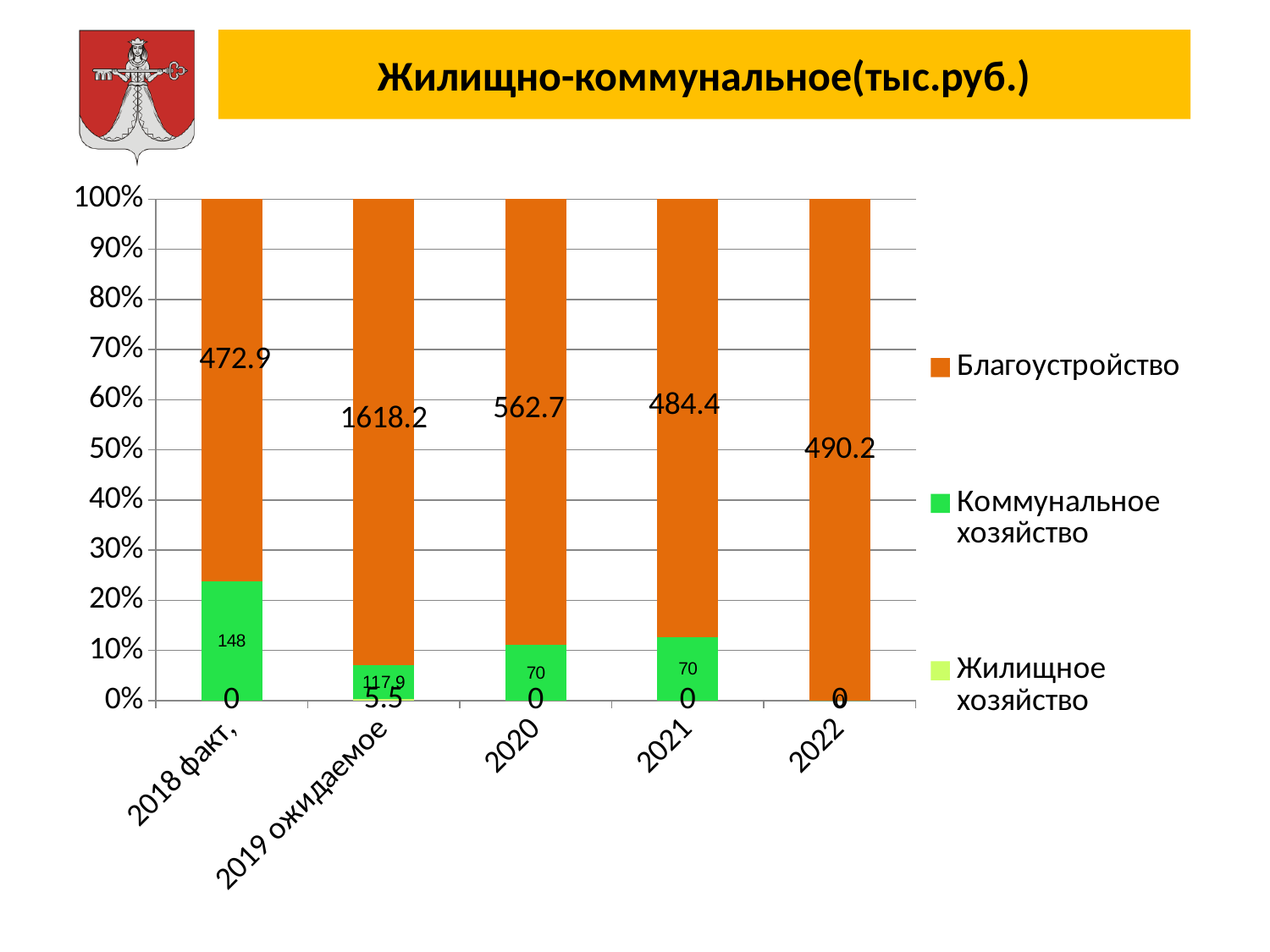
Which category has the highest value for Благоустройство? 2019 ожидаемое What is the value of Жилищное хозяйство for 2019 ожидаемое? 5.5 What is the value of Благоустройство for 2019 ожидаемое? 1618.2 What kind of chart is shown on the slide? stacked bar chart What is the title of the chart? Жилищно-коммунальное(тыс.руб.) Which category has the lowest value for Благоустройство? 2018 факт Which is larger: Коммунальное хозяйство for 2018 факт or for 2019 ожидаемое? 2018 факт How many categories are shown on the x axis? 5 What is the total of the stacked bar for 2020? 632.7 What is the difference between the Благоустройство values for 2020 and 2021? 78.3 What is the value of Коммунальное хозяйство for 2018 факт? 148 How many series does the legend list? 3